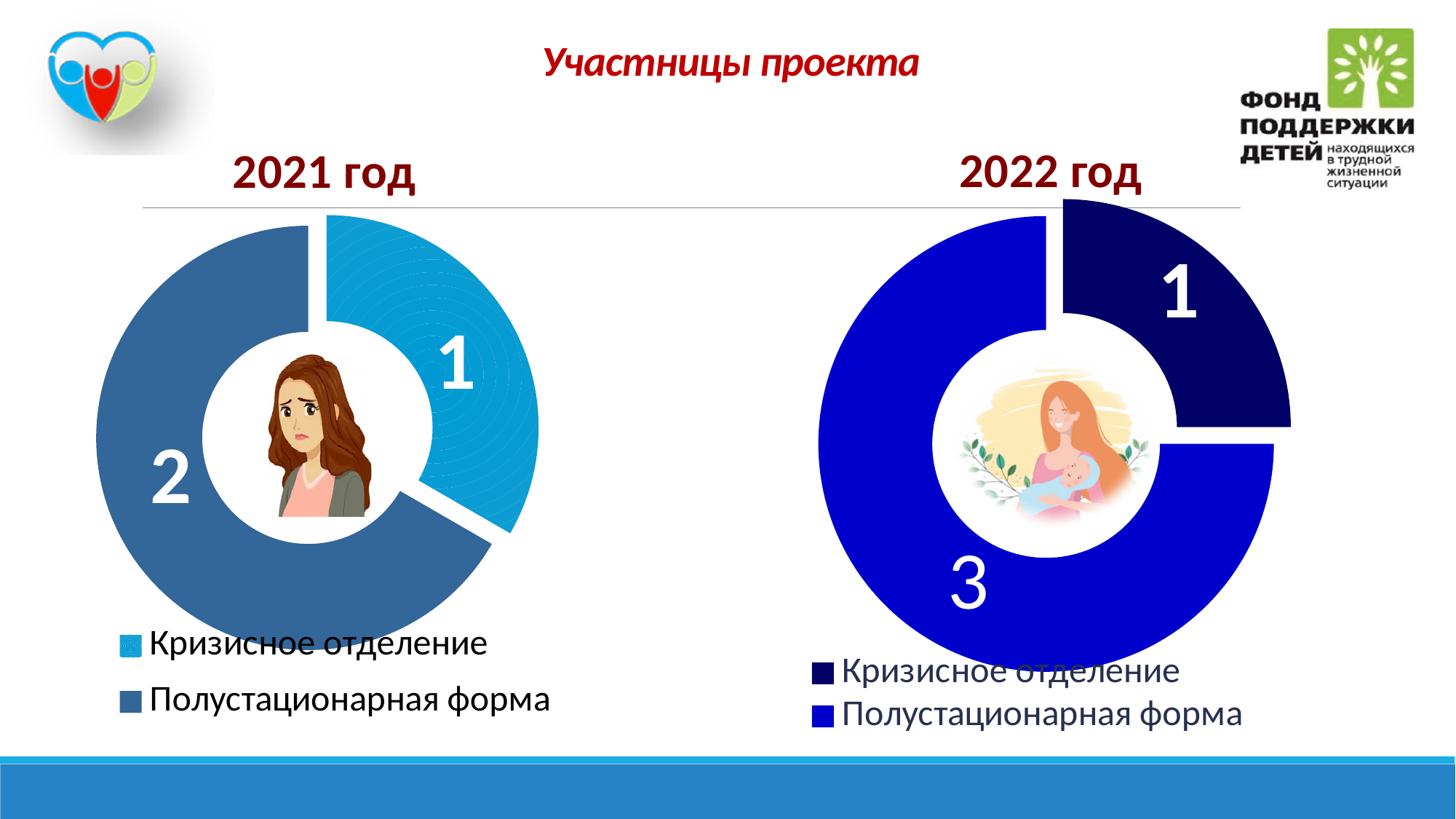
On the 2022 год chart, what is the value for Полустационарная форма? 3 How many categories does the 2021 год chart show? 2 On the 2021 год chart, what is the value for Кризисное отделение? 1 What type of chart is used for 2022 год? Doughnut (pie) chart What share of the 2022 год chart does Полустационарная форма represent? 75% On the 2021 год chart, which category has the smallest value? Кризисное отделение On the 2021 год chart, what is the value for Полустационарная форма? 2 On the 2022 год chart, what is the value for Кризисное отделение? 1 Which is larger on the 2021 год chart: Кризисное отделение or Полустационарная форма? Полустационарная форма What share of the 2021 год chart does Кризисное отделение represent? 33% On the 2022 год chart, what is the difference between Полустационарная форма and Кризисное отделение? 2 On the 2022 год chart, which category has the largest value? Полустационарная форма